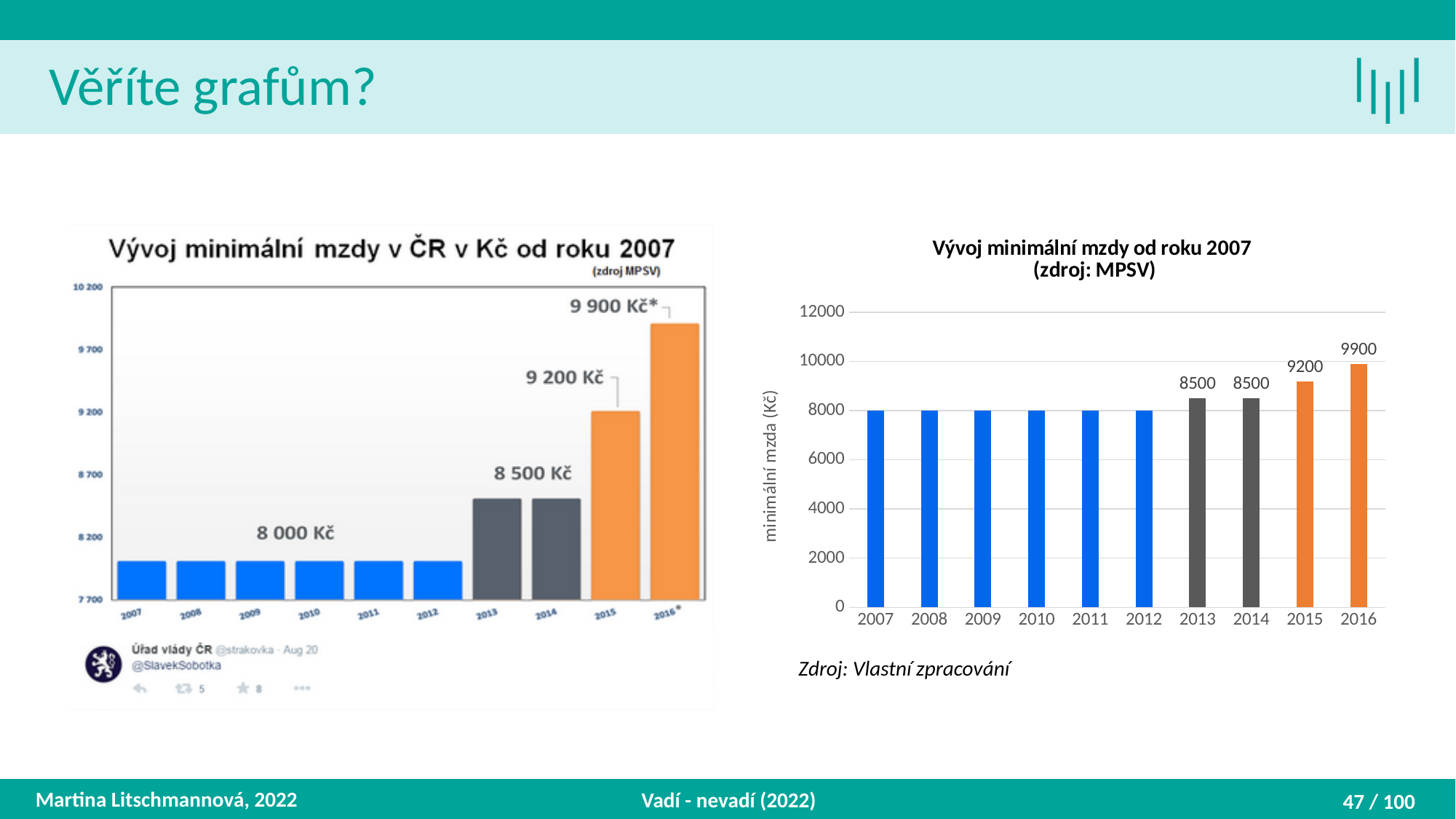
On the right-hand chart, what is the value shown for 2015? 9200 What kind of chart is the right-hand chart? bar chart On the right-hand chart, do the values rise or fall from 2012 to 2016? rise On the left-hand chart, what value is labelled for the years 2007 to 2012? 8 000 Kč On the right-hand chart, what is the difference between the values for 2015 and 2014? 700 On the right-hand chart, how many years are shown on the x axis? 10 On the right-hand chart, is the value for 2016 greater or less than 10000? less On the left-hand chart, what value is labelled for 2015? 9 200 Kč On the right-hand chart, what is the difference between the values for 2016 and 2015? 700 On the right-hand chart, what is the value shown for 2013? 8500 On the right-hand chart, what is the minimum wage value shown for 2016? 9900 On the right-hand chart, which year has the highest value? 2016